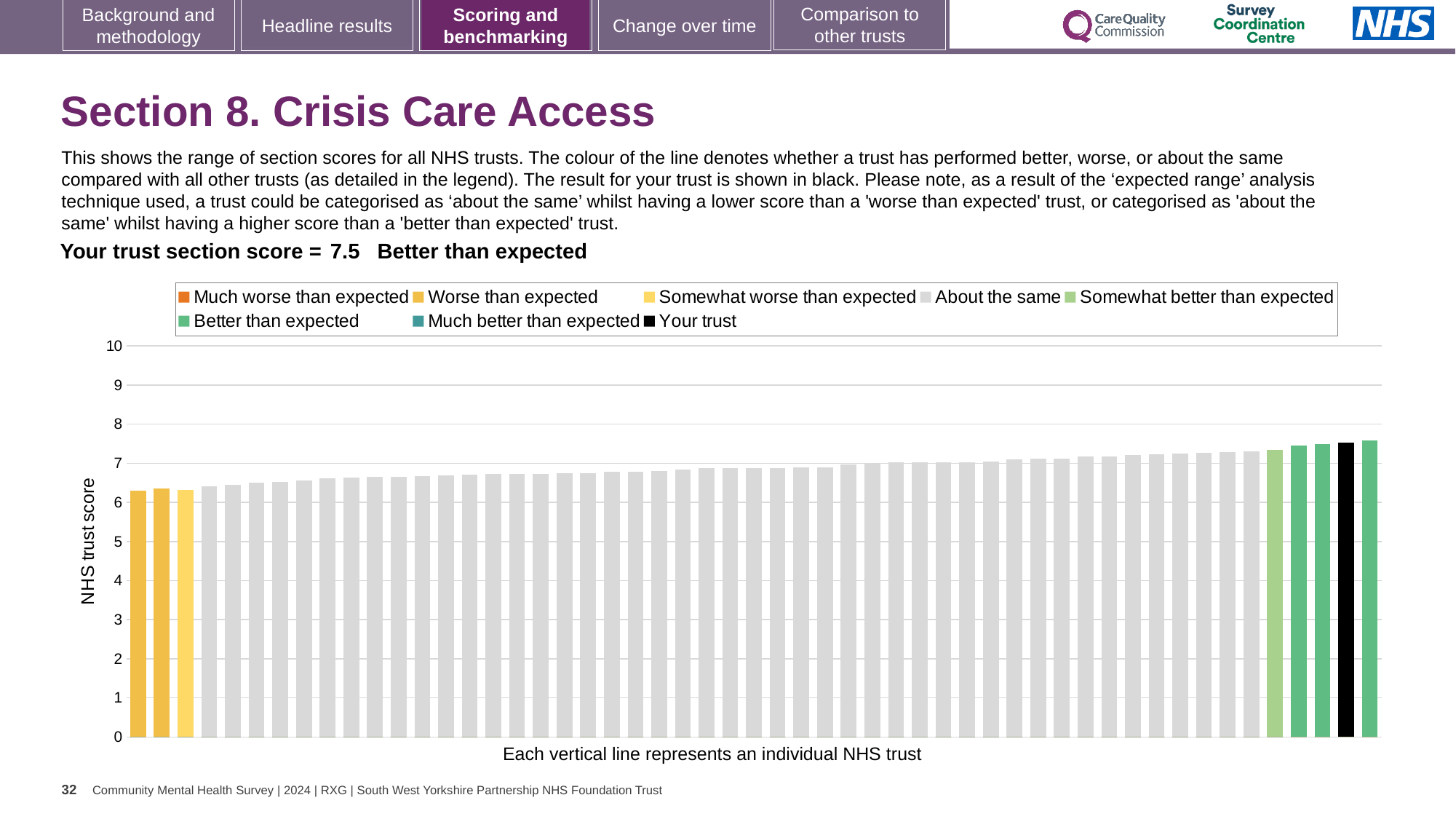
Is the highest bar on the chart greater or less than 8? less How many bars are coloured as 'Somewhat better than expected'? 1 Which category is your trust's section score placed in? Better than expected How many bars are coloured as 'Worse than expected'? 2 What colour is used to show your trust on the chart? black What kind of chart is shown on the slide? bar chart What is the section score for your trust? 7.5 Is the value for your trust (the black bar) greater or less than 7? greater Is the lowest bar on the chart greater or less than 6? greater Do the bar values rise or fall from left to right across the chart? rise How many entries does the chart legend list? 8 What is the label on the vertical axis of the chart? NHS trust score